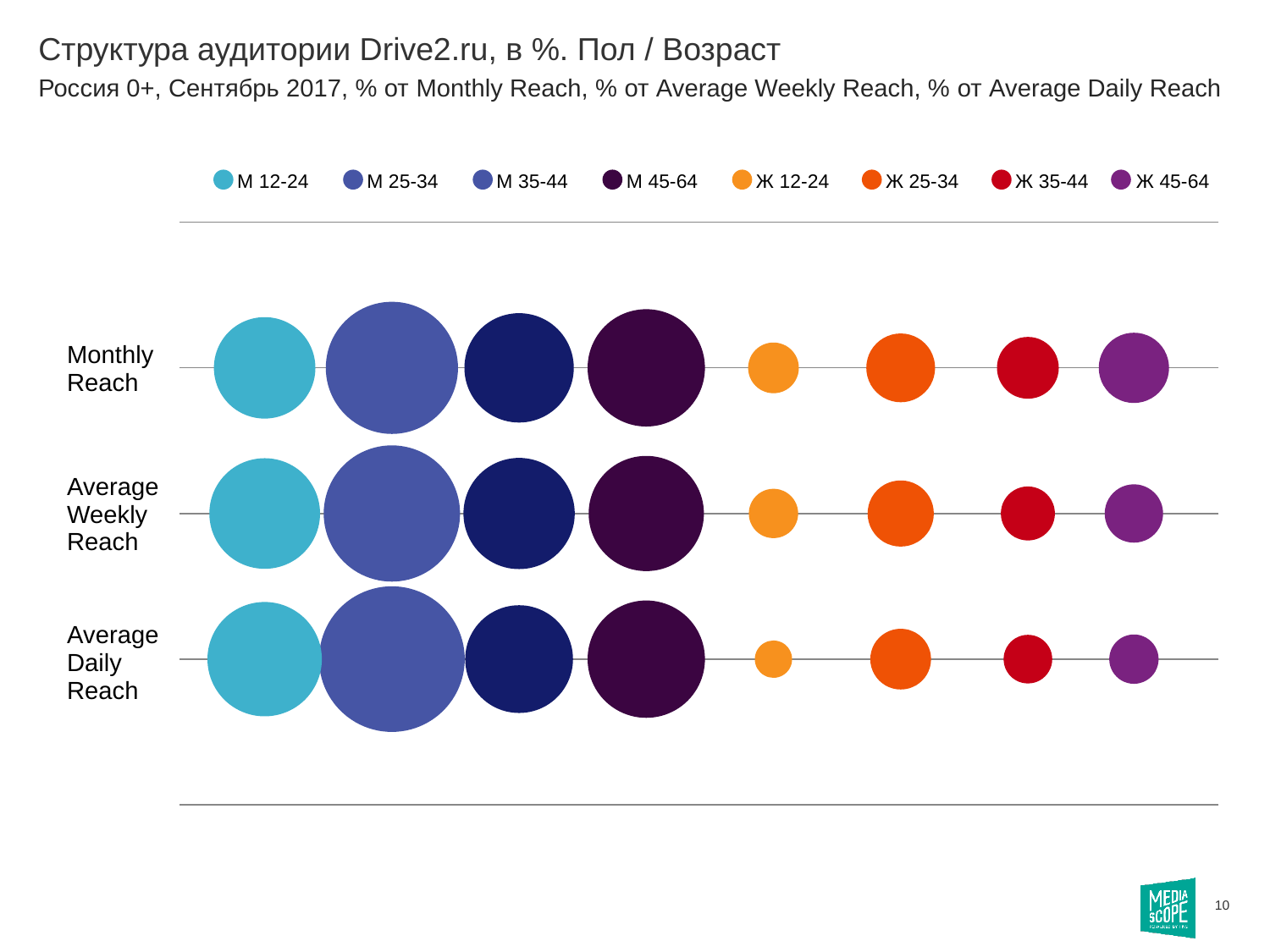
Which gender/age group has the smallest bubble in the Average Daily Reach row? Ж 12-24 In the Monthly Reach row, which bubble is larger: М 45-64 or Ж 45-64? М 45-64 What kind of chart is shown on the slide? Bubble chart Which website's audience structure is shown in the chart title? Drive2.ru How many series does the legend list? 8 Which gender/age group has the largest bubble in the Monthly Reach row? М 25-34 Which gender/age group has the largest bubble in the Average Daily Reach row? М 25-34 For Ж 12-24, which bubble is larger: Monthly Reach or Average Daily Reach? Monthly Reach Which month and year does the chart subtitle refer to? Сентябрь 2017 In the Average Weekly Reach row, which bubble is larger: М 12-24 or Ж 25-34? М 12-24 How many reach categories (rows) are plotted on the chart? 3